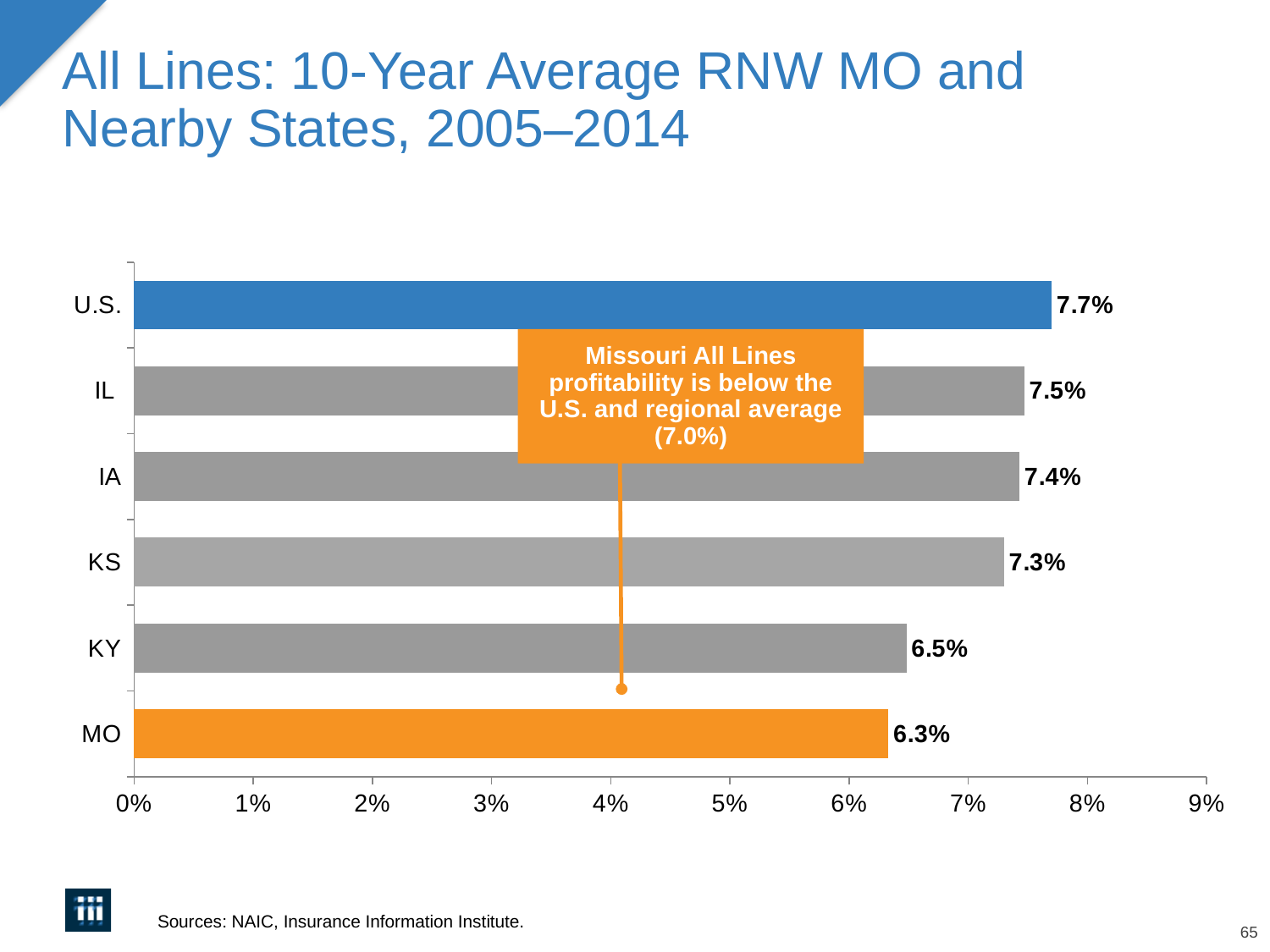
What kind of chart is shown on the slide? Bar chart Which category has the highest 10-year average RNW? U.S. Which state has the lowest 10-year average RNW? MO What is the difference between the IL value and the KS value? 0.2% What is the 10-year average RNW for the U.S.? 7.7% Which has a higher 10-year average RNW, IA or KY? IA Is the value for KS greater or less than 7%? greater What is the 10-year average RNW for MO? 6.3% What is the value shown for KY? 6.5% What is the difference between the U.S. value and the MO value? 1.4% How many categories are shown on the chart? 6 What regional average is stated in the callout box on the chart? 7.0%